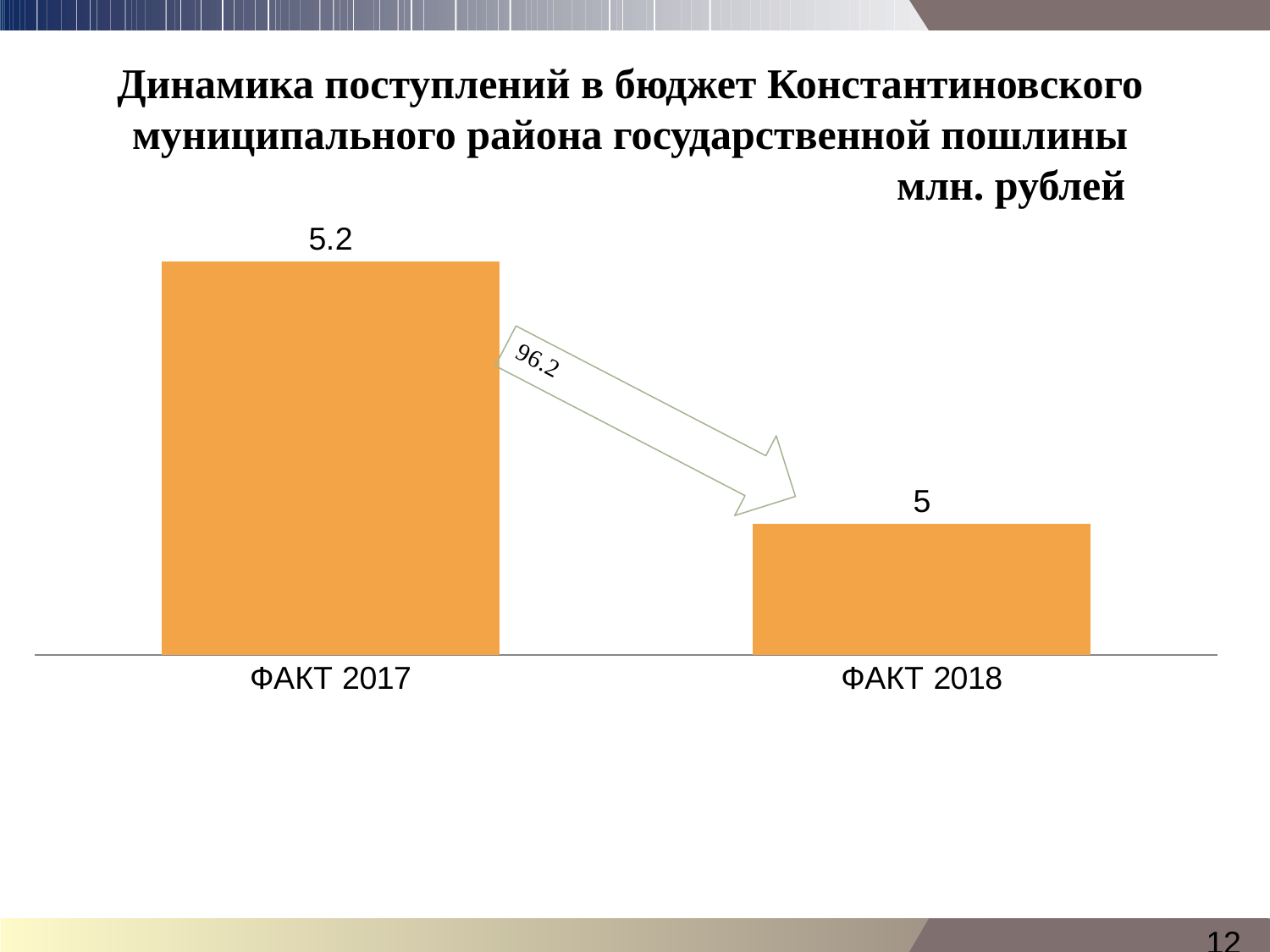
How many categories are shown in the chart? 2 What unit of measurement is stated for the chart? млн. рублей What is the value for ФАКТ 2017? 5.2 What kind of chart is shown on the slide? bar chart Which category has the lowest value? ФАКТ 2018 Which is larger, the value for ФАКТ 2017 or ФАКТ 2018? ФАКТ 2017 Which category has the highest value? ФАКТ 2017 What number is written on the arrow between the two bars? 96.2 What is the difference between the values for ФАКТ 2017 and ФАКТ 2018? 0.2 What is the value for ФАКТ 2018? 5 Do the values rise or fall from ФАКТ 2017 to ФАКТ 2018? fall